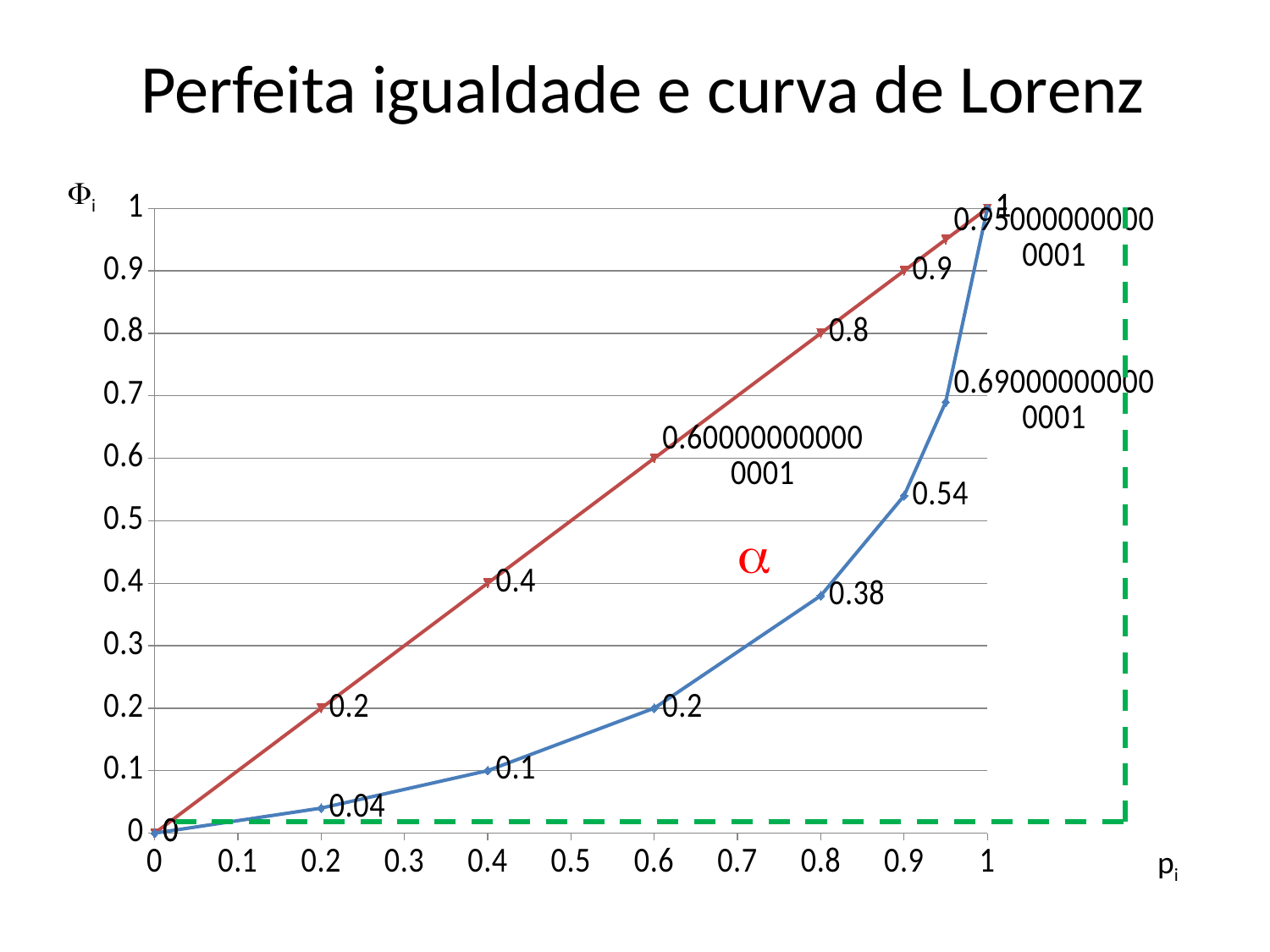
How many data points are plotted on the blue (Lorenz) curve? 8 Does the blue (Lorenz) curve rise or fall as p increases from 0 to 1? rises What is the value of the red (perfect equality) line at p = 0.4? 0.4 What is the difference between the red line value and the blue curve value at p = 0.8? 0.42 What is the value of the blue (Lorenz) curve at p = 0.8? 0.38 What is the value of the blue (Lorenz) curve at p = 0.9? 0.54 What is the value of the blue (Lorenz) curve at p = 0.2? 0.04 At p = 0.6, which series has the larger value, the red line or the blue curve? the red line What is the difference between the red line value and the blue curve value at p = 0.4? 0.3 What is the title of the chart on the slide? Perfeita igualdade e curva de Lorenz What kind of chart is shown on the slide? line chart Is the value of the blue curve at p = 0.8 greater or less than 0.5? less